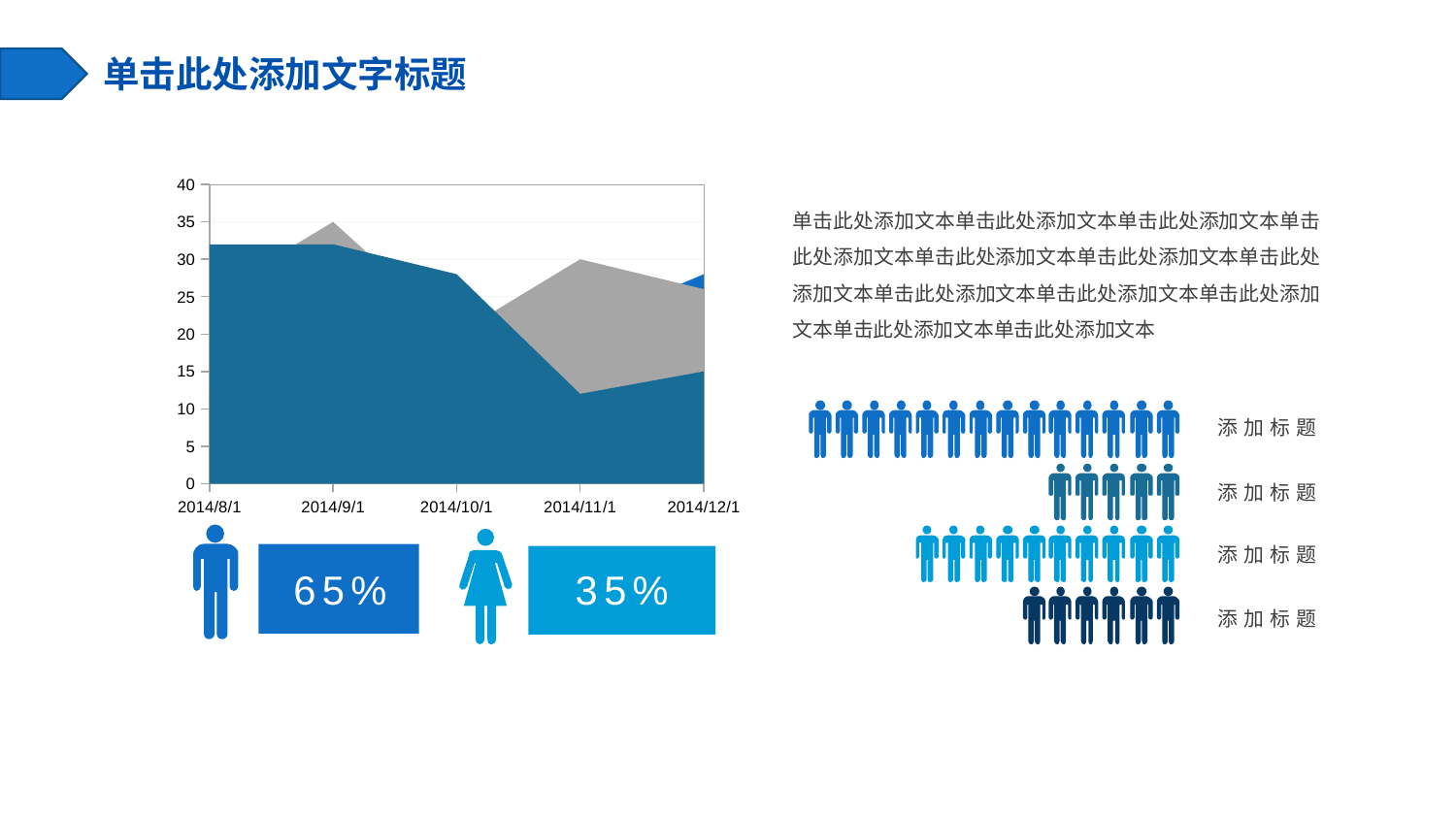
What is the first date shown on the x axis of the area chart? 2014/8/1 How many dates are shown on the x axis of the area chart? 5 In the area chart, is the gray series value at 2014/9/1 greater or less than 30? greater In the area chart, is the gray series value at 2014/11/1 greater or less than 25? greater In the area chart, is the dark blue series value at 2014/11/1 greater or less than 15? less In the area chart, at which date does the gray series reach its highest value? 2014/9/1 What is the highest value shown on the y axis of the area chart? 40 What kind of chart is shown on the left of the slide? area chart In the area chart, does the dark blue series rise or fall from 2014/9/1 to 2014/11/1? fall In the area chart, at which date does the dark blue series reach its lowest value? 2014/11/1